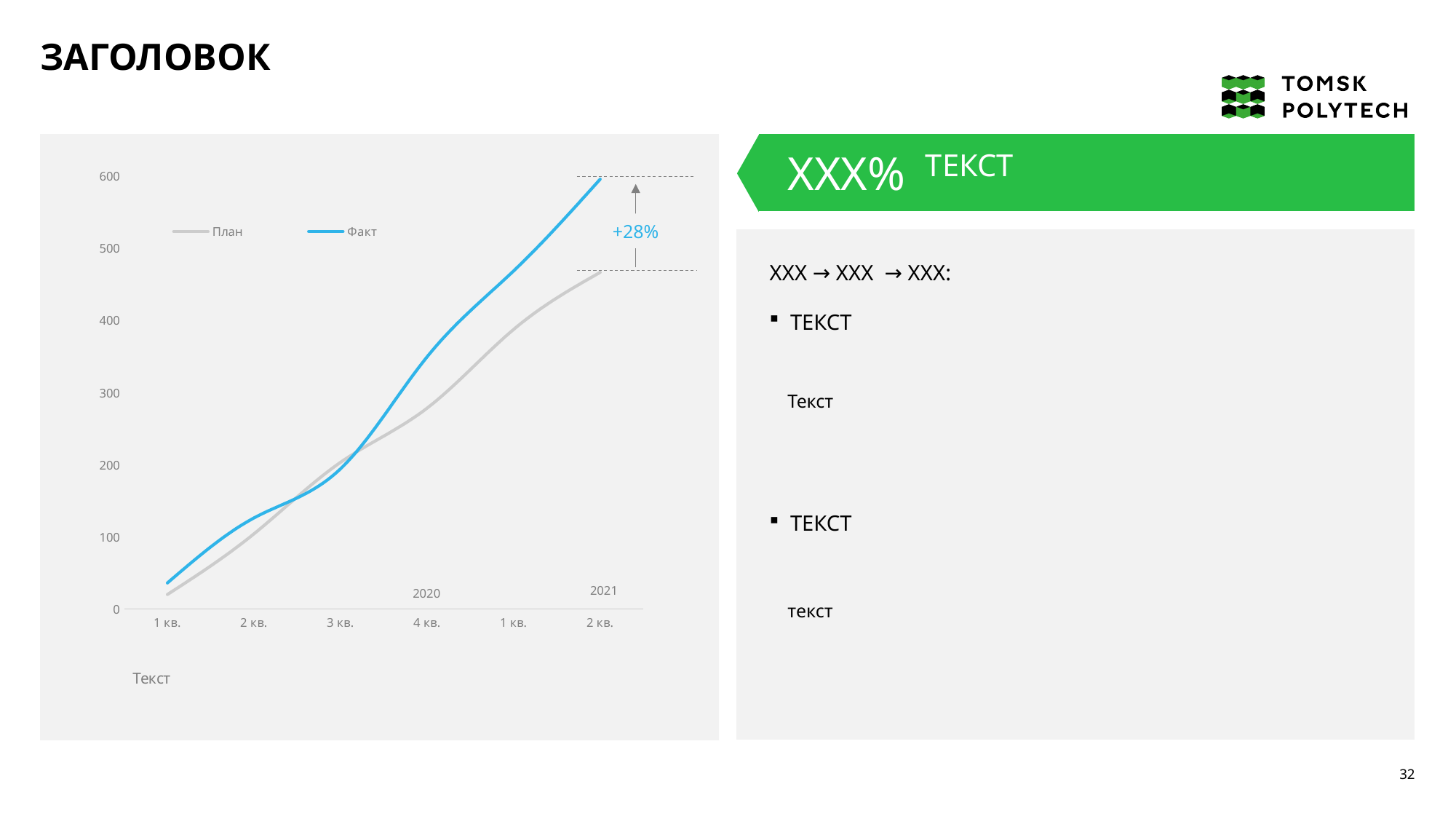
How many series does the chart legend list? 2 What kind of chart is shown on the slide? line chart Is the Факт value for 4 кв. 2020 greater or less than 300? greater What are the two series named in the chart legend? План and Факт Is the План value for 2 кв. 2021 greater or less than 500? less Does the Факт line rise or fall from 1 кв. 2020 to 2 кв. 2021? rises What percentage difference is annotated between the Факт and План lines at the end of the chart? +28% In which quarter does the Факт line reach its highest value? 2 кв. 2021 How many quarters are plotted along the x axis of the chart? 6 At 2 кв. 2021, which series has the larger value, План or Факт? Факт Is the Факт value for 2 кв. 2021 greater or less than 500? greater